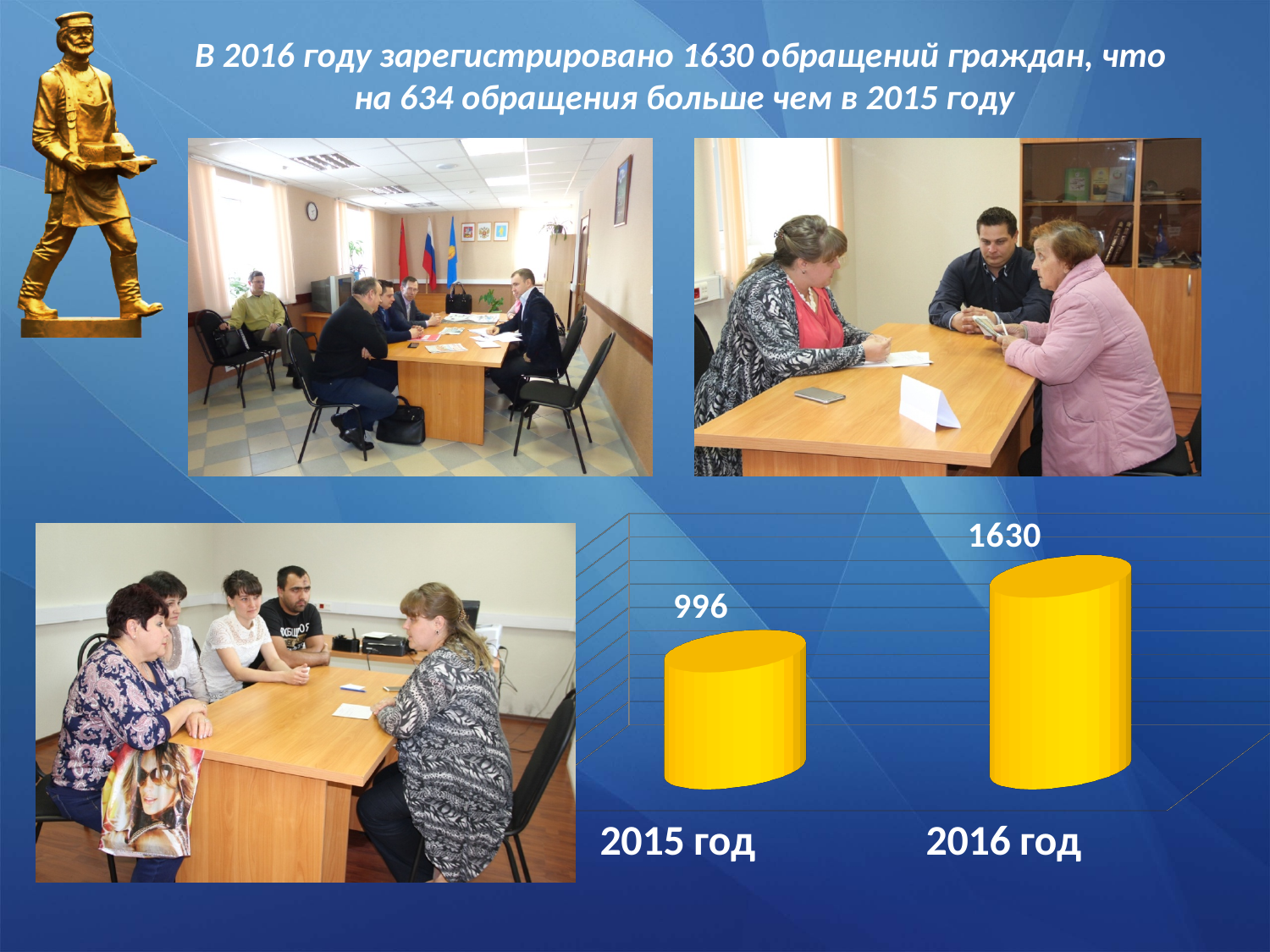
What is the difference between the values for 2016 год and 2015 год? 634 Is the value for 2015 год greater or less than 1000? less Which year has the lower value on the chart? 2015 год What kind of chart is shown on the slide? bar chart Which year has the higher value on the chart? 2016 год How many categories are plotted on the chart? 2 Is the value for 2016 год larger or smaller than the value for 2015 год? larger What colour are the bars on the chart? yellow What is the value shown for 2015 год? 996 Do the values rise or fall from 2015 год to 2016 год? rise What is the value shown for 2016 год? 1630